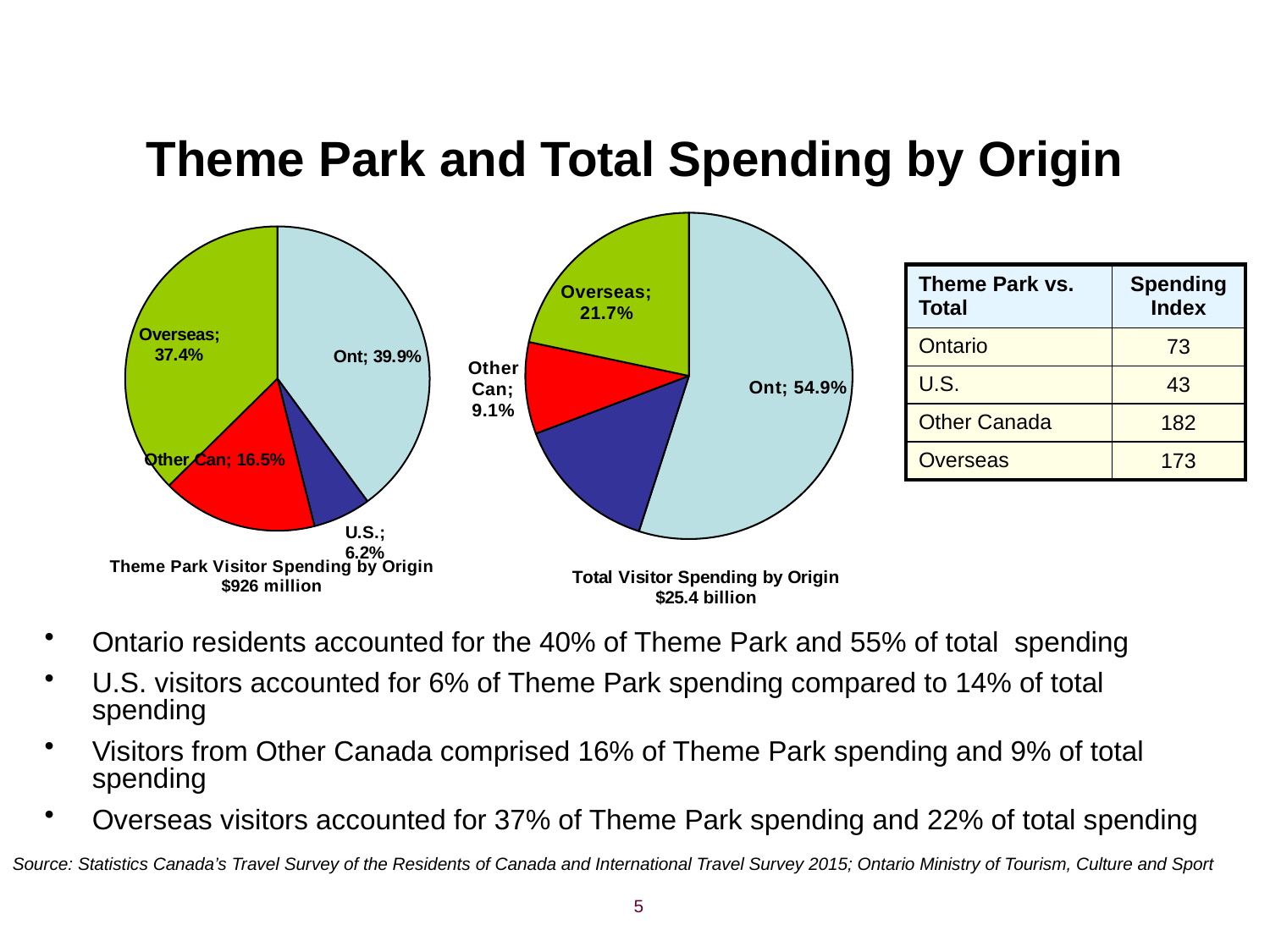
What total dollar amount is shown beneath the Theme Park Visitor Spending by Origin pie chart? $926 million What type of chart is used to show Total Visitor Spending by Origin? Pie chart In the Total Visitor Spending by Origin pie chart, what share of spending comes from Ontario? 54.9% In the Theme Park Visitor Spending by Origin pie chart, what share of spending comes from Overseas visitors? 37.4% In the Theme Park Visitor Spending by Origin pie chart, what share of spending comes from Ontario? 39.9% In the Total Visitor Spending by Origin pie chart, which slice is larger: Overseas or Other Can? Overseas In the Total Visitor Spending by Origin pie chart, which origin has the largest slice? Ont In the Theme Park Visitor Spending by Origin pie chart, which origin has the smallest slice? U.S. In the Theme Park Visitor Spending by Origin pie chart, what is the difference in percentage points between the Ontario and Overseas slices? 2.5 percentage points In the Total Visitor Spending by Origin pie chart, what share of spending comes from Other Canada? 9.1% In the Theme Park Visitor Spending by Origin pie chart, what share of spending comes from the U.S.? 6.2% How many slices does the Theme Park Visitor Spending by Origin pie chart have? 4